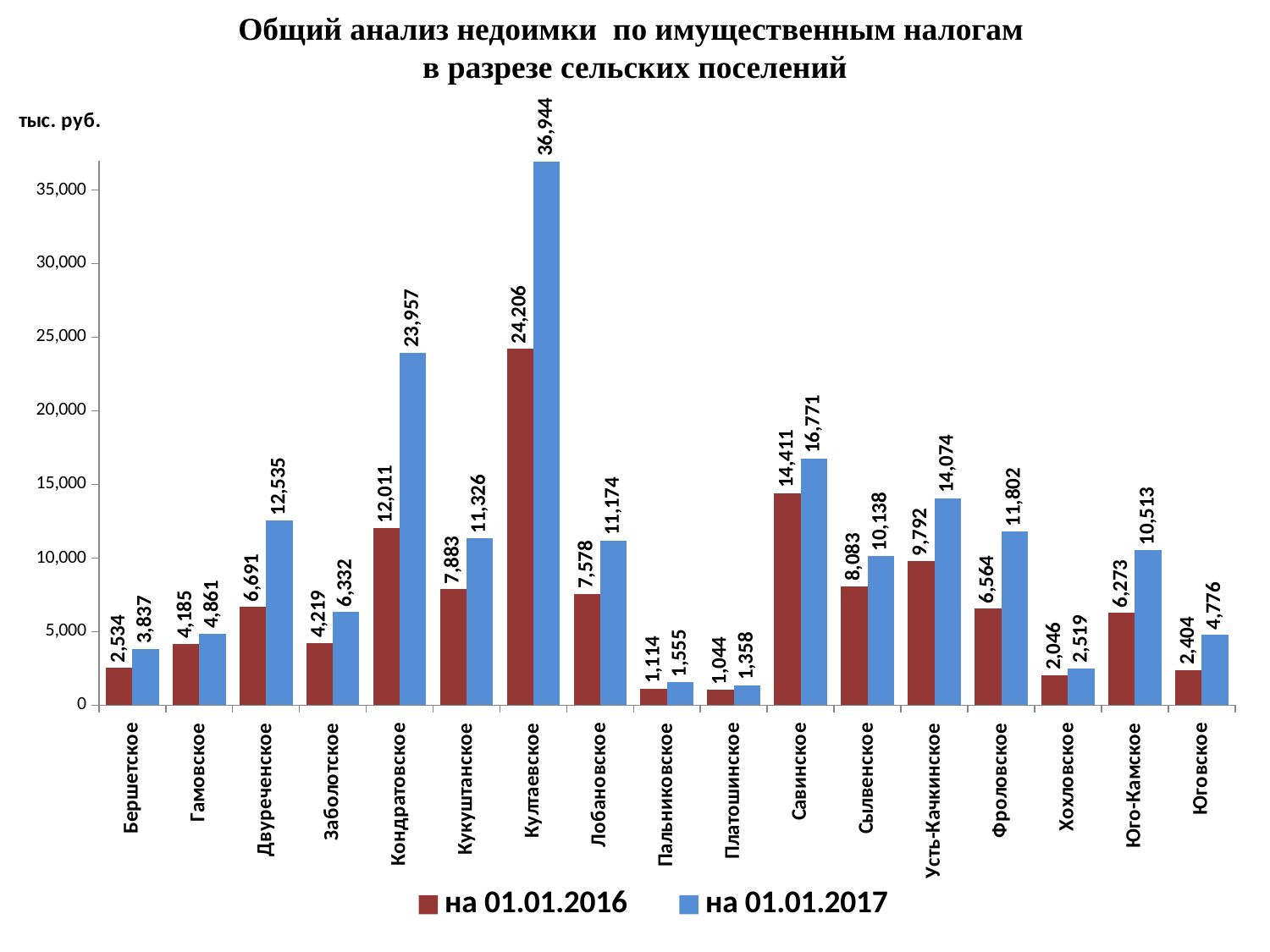
What is the value for Савинское in the series на 01.01.2016? 14,411 Which category has the lowest value in the series на 01.01.2016? Платошинское What unit is indicated for the values on the chart? тыс. руб. Is the value for Фроловское на 01.01.2017 greater or less than 10,000? greater How many series does the legend list? 2 What is the difference between the на 01.01.2017 and на 01.01.2016 values for Култаевское? 12,738 What kind of chart is shown on the slide? bar chart What is the value for Кондратовское in the series на 01.01.2017? 23,957 How many categories (settlements) are shown on the x axis? 17 Which is larger for Усть-Качкинское: the value на 01.01.2016 or на 01.01.2017? на 01.01.2017 What is the value for Юго-Камское in the series на 01.01.2017? 10,513 Which category has the highest value in the series на 01.01.2017? Култаевское